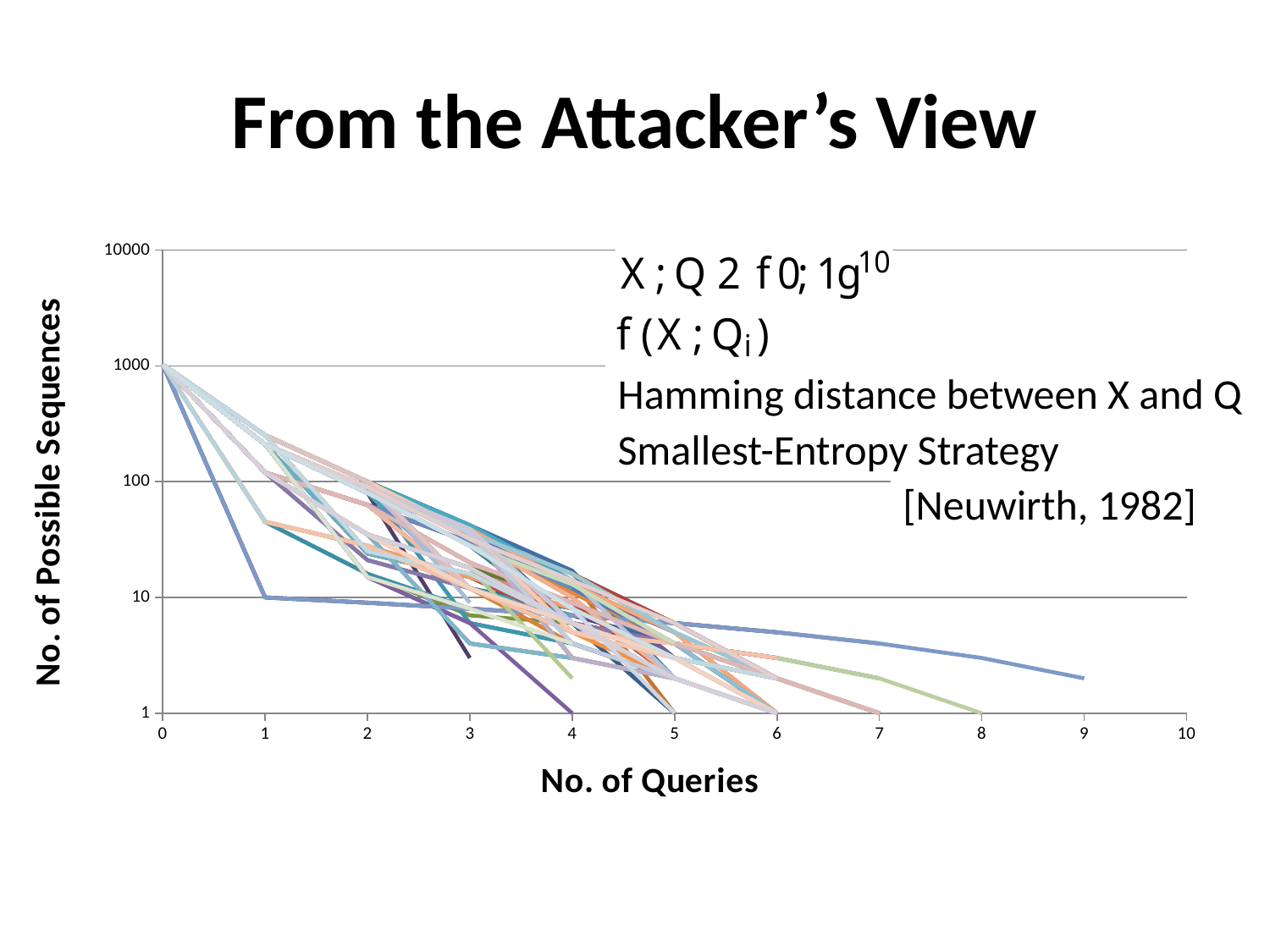
Is the value of the longest line at 9 queries greater or less than 10? less Is the value of the lowest line at 2 queries greater or less than 100? less What is the title of the slide containing the chart? From the Attacker's View What kind of chart is shown on the slide? line chart What is the highest tick value shown on the x axis? 10 What is the lowest tick value shown on the y axis? 1 Do the plotted lines rise or fall as the number of queries increases? fall What is the label of the x axis? No. of Queries Is the value of the lowest line at 1 query greater or less than 100? less What is the highest tick value shown on the y axis? 10000